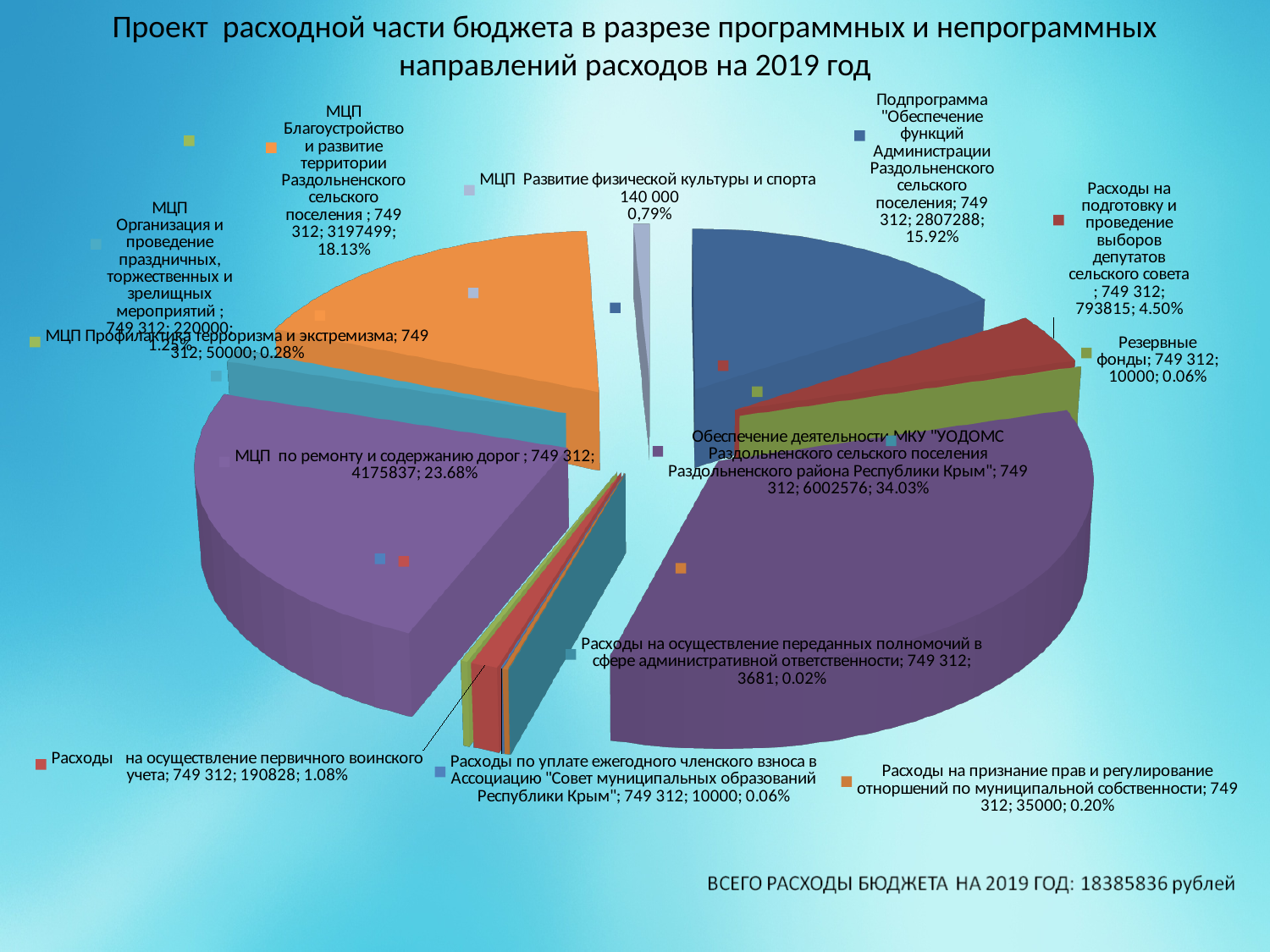
What percentage share does "МЦП Благоустройство и развитие территории Раздольненского сельского поселения" have? 18.13% What is the value for "МЦП по ремонту и содержанию дорог"? 4175837 Which is larger: the value for "МЦП Профилактика терроризма и экстремизма" or "Резервные фонды"? МЦП Профилактика терроризма и экстремизма What is the value for "Расходы на осуществление первичного воинского учета"? 190828 How many categories (slices) does the pie chart have? 13 What kind of chart is shown on the slide? Pie chart What percentage share does "Подпрограмма "Обеспечение функций Администрации Раздольненского сельского поселения"" have? 15.92% Which category has the smallest share of the budget expenditure? Расходы на осуществление переданных полномочий в сфере административной ответственности What is the difference between the value for "Обеспечение деятельности МКУ" (6002576) and "МЦП по ремонту и содержанию дорог" (4175837)? 1826739 What is the total budget expenditure for 2019 stated on the slide? 18385836 рублей Which category has the largest share of the budget expenditure? Обеспечение деятельности МКУ "УОДОМС Раздольненского сельского поселения Раздольненского района Республики Крым" What is the value for "Расходы на подготовку и проведение выборов депутатов сельского совета"? 793815